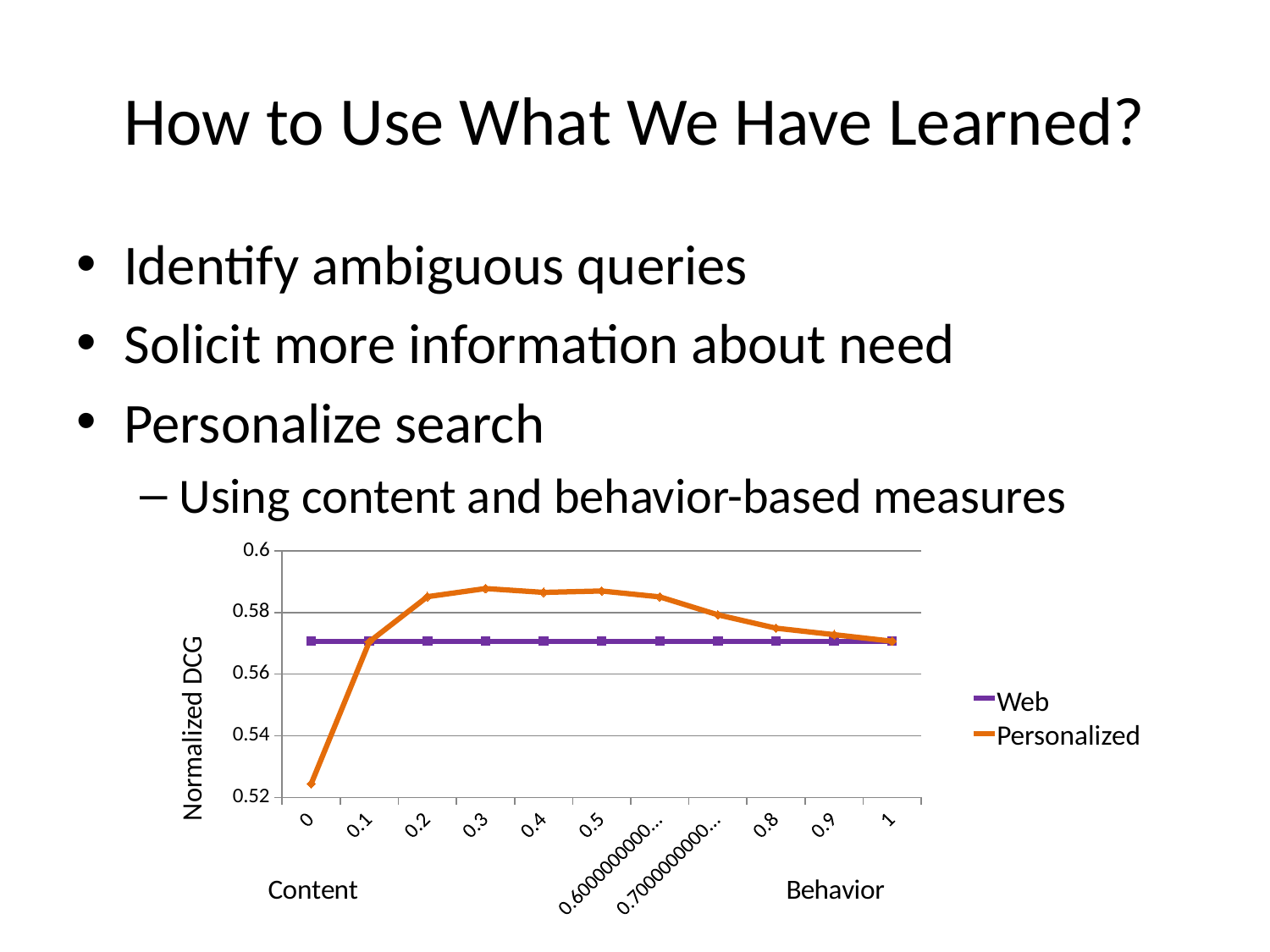
At x = 0, which series has the higher value, Web or Personalized? Web Which series is drawn in orange? Personalized How many points are plotted along the x axis for each series? 11 Is the Personalized value at x = 0.3 greater or less than 0.58? greater What is the label of the y axis? Normalized DCG What kind of chart is shown on the slide? line chart Does the Personalized series rise or fall between x = 0 and x = 0.2? rise How many series does the chart's legend list? 2 Is the Web value at x = 0.5 greater or less than 0.58? less At which x value does the Personalized series reach its lowest point? 0 At x = 0.4, which series has the higher value, Web or Personalized? Personalized Is the Personalized value at x = 0 greater or less than 0.54? less